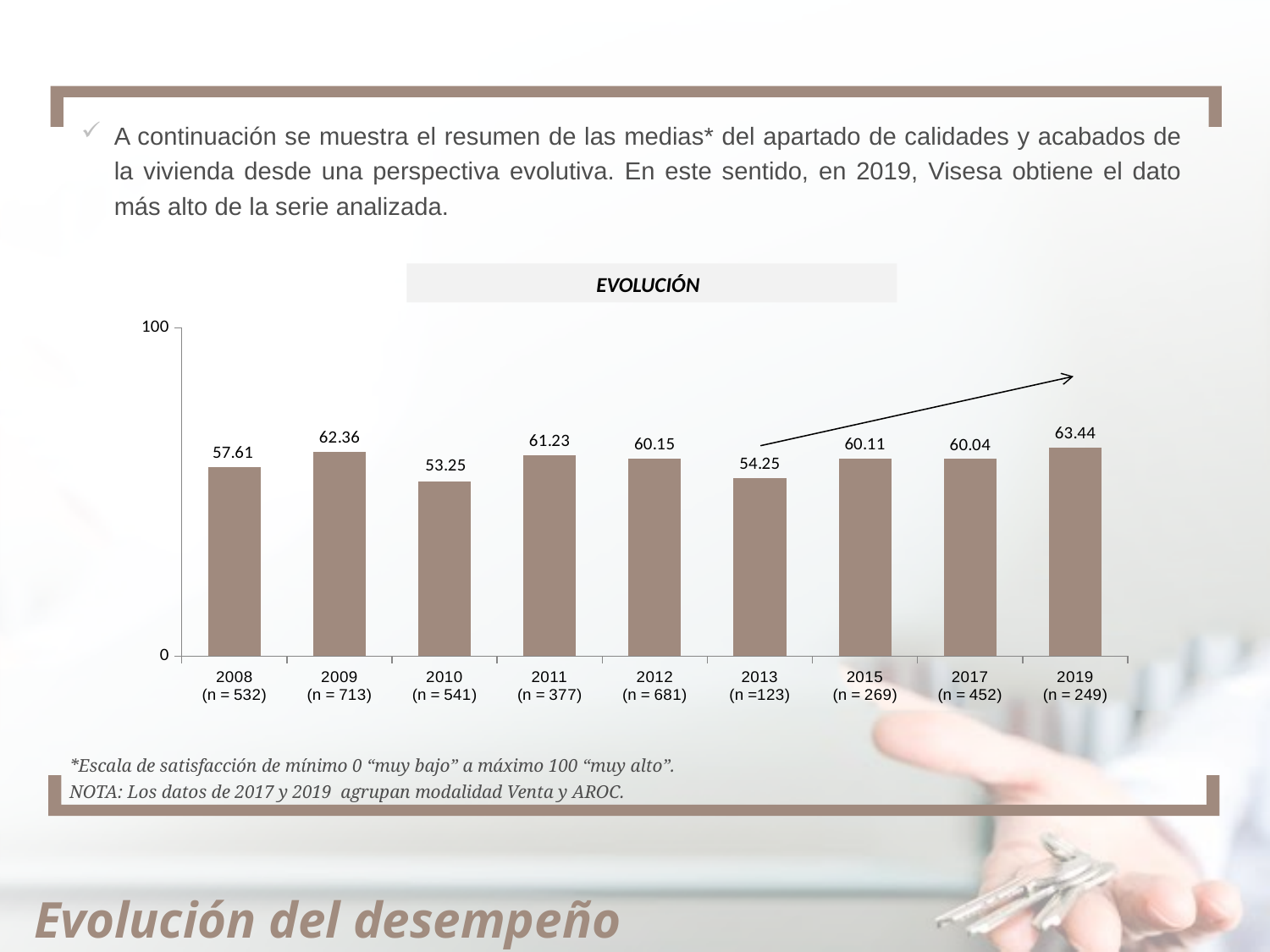
What is the difference between the values for 2009 and 2010 in the EVOLUCIÓN chart? 9.11 What is the sample size (n) shown for 2012 in the EVOLUCIÓN chart? n = 681 How many years (bars) are shown in the EVOLUCIÓN chart? 9 Which is larger in the EVOLUCIÓN chart, the value for 2011 or the value for 2013? 2011 Which year has the highest value in the EVOLUCIÓN chart? 2019 What is the value for 2013 in the EVOLUCIÓN chart? 54.25 What kind of chart is the EVOLUCIÓN chart? Bar chart What is the difference between the values for 2019 and 2008 in the EVOLUCIÓN chart? 5.83 What is the maximum value shown on the vertical axis of the EVOLUCIÓN chart? 100 What is the value for 2010 in the EVOLUCIÓN chart? 53.25 What is the value for 2019 in the EVOLUCIÓN chart? 63.44 Which year has the lowest value in the EVOLUCIÓN chart? 2010